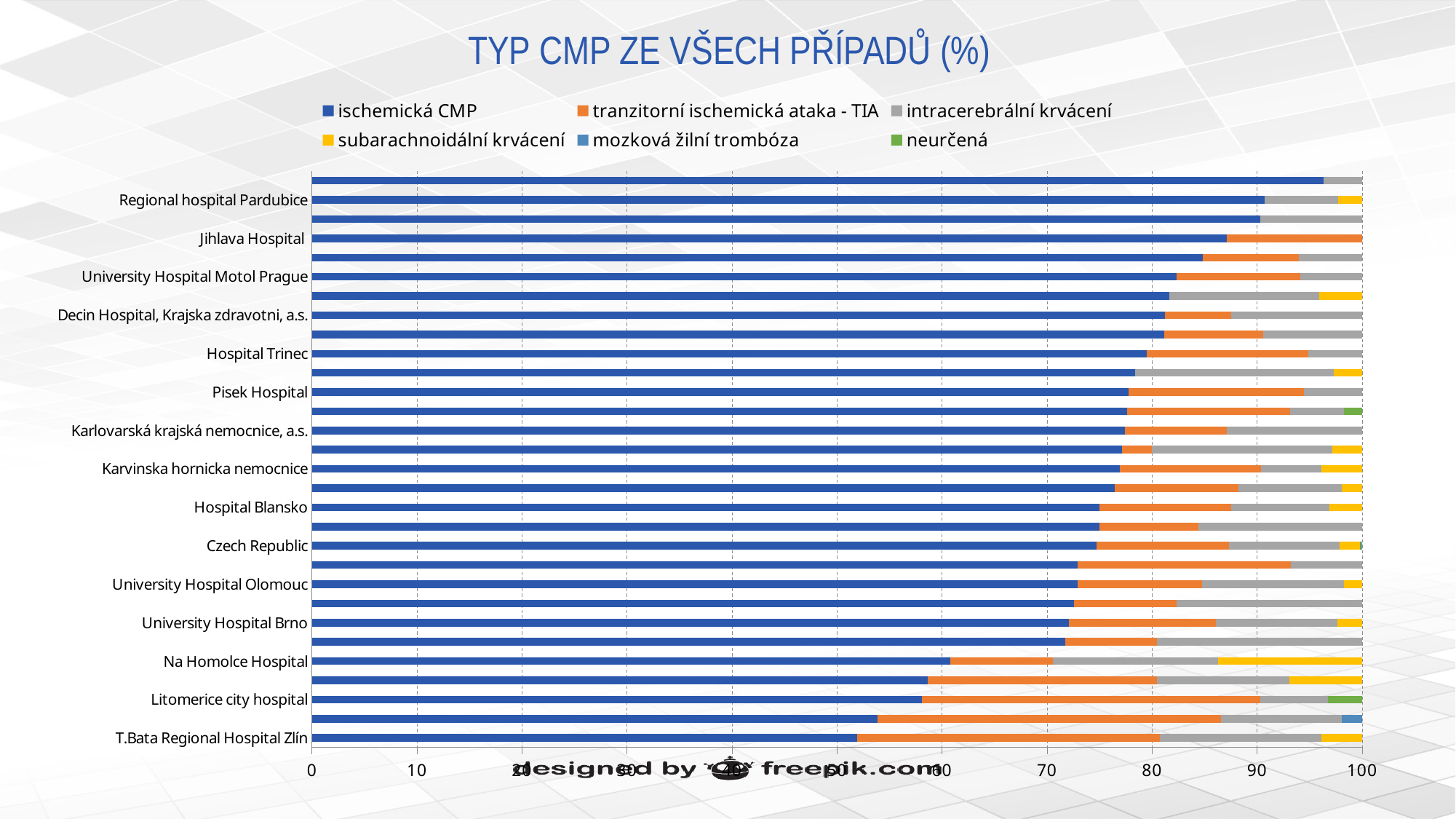
Is the value of ischemická CMP for Na Homolce Hospital greater or less than 70? less What is the title of the chart? TYP CMP ZE VŠECH PŘÍPADŮ (%) Is the value of ischemická CMP for Jihlava Hospital greater or less than 80? greater Is the value of ischemická CMP for Hospital Blansko greater or less than 80? less Which has a larger share of ischemická CMP, Jihlava Hospital or Na Homolce Hospital? Jihlava Hospital Which colour represents the series "neurčená" in the legend? green What kind of chart is shown on the slide? stacked bar chart How many series does the legend list? 6 Do the ischemická CMP shares rise or fall going from the top bar to the bottom bar of the chart? fall